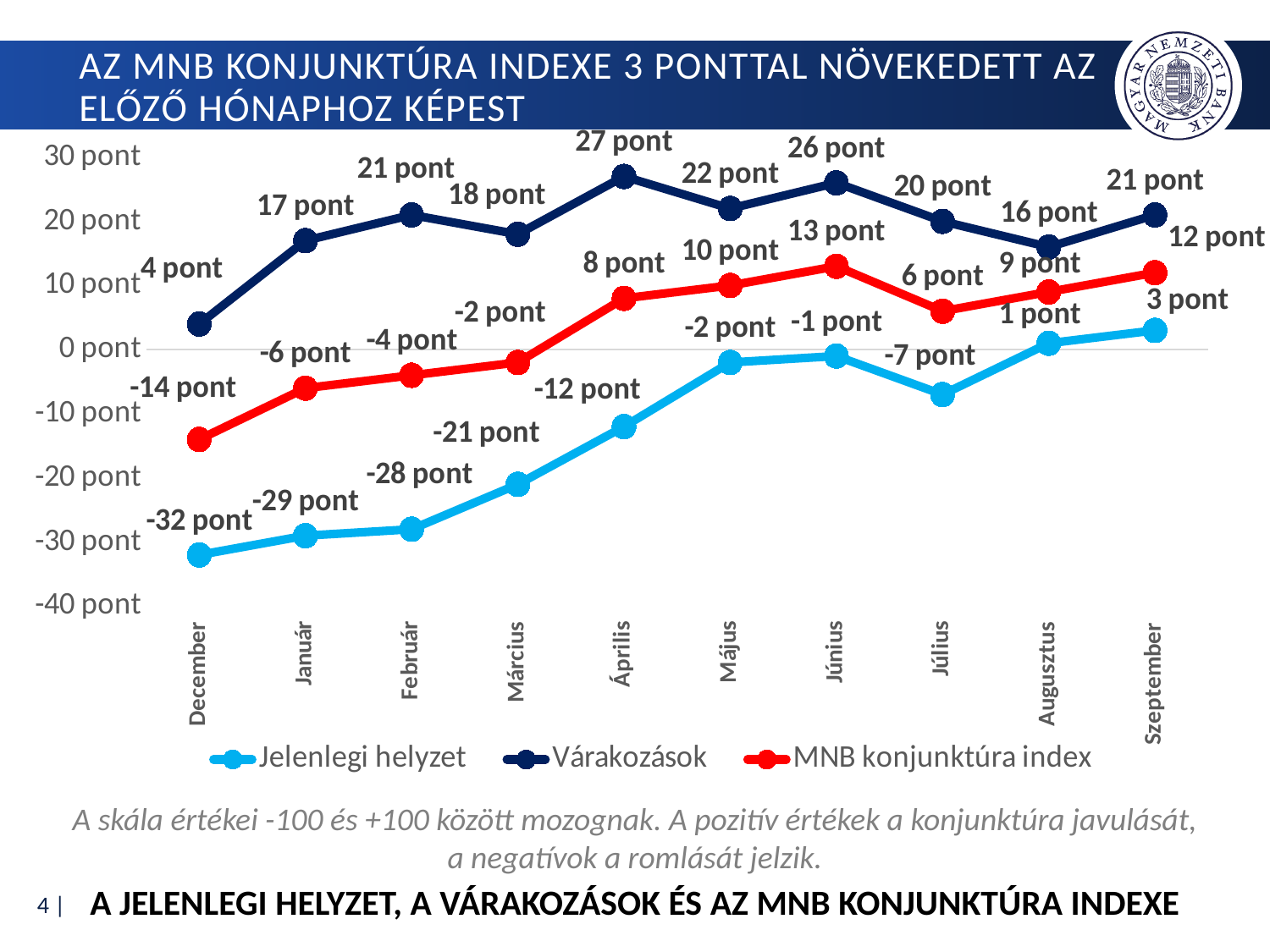
What is the value of Várakozások in Április? 27 pont Which series is drawn in red? MNB konjunktúra index How many series does the legend list? 3 Does the Jelenlegi helyzet series generally rise or fall from December to Szeptember? rise What is the value of the MNB konjunktúra index in Szeptember? 12 pont What is the difference between the MNB konjunktúra index in Szeptember and in Augusztus? 3 pont What type of chart is shown on the slide? line chart In which month is the Jelenlegi helyzet series at its lowest? December Which is larger in Július: Várakozások or the MNB konjunktúra index? Várakozások How many months are plotted along the x axis? 10 In which month is the Várakozások series at its highest? Április What is the value of Jelenlegi helyzet in December? -32 pont